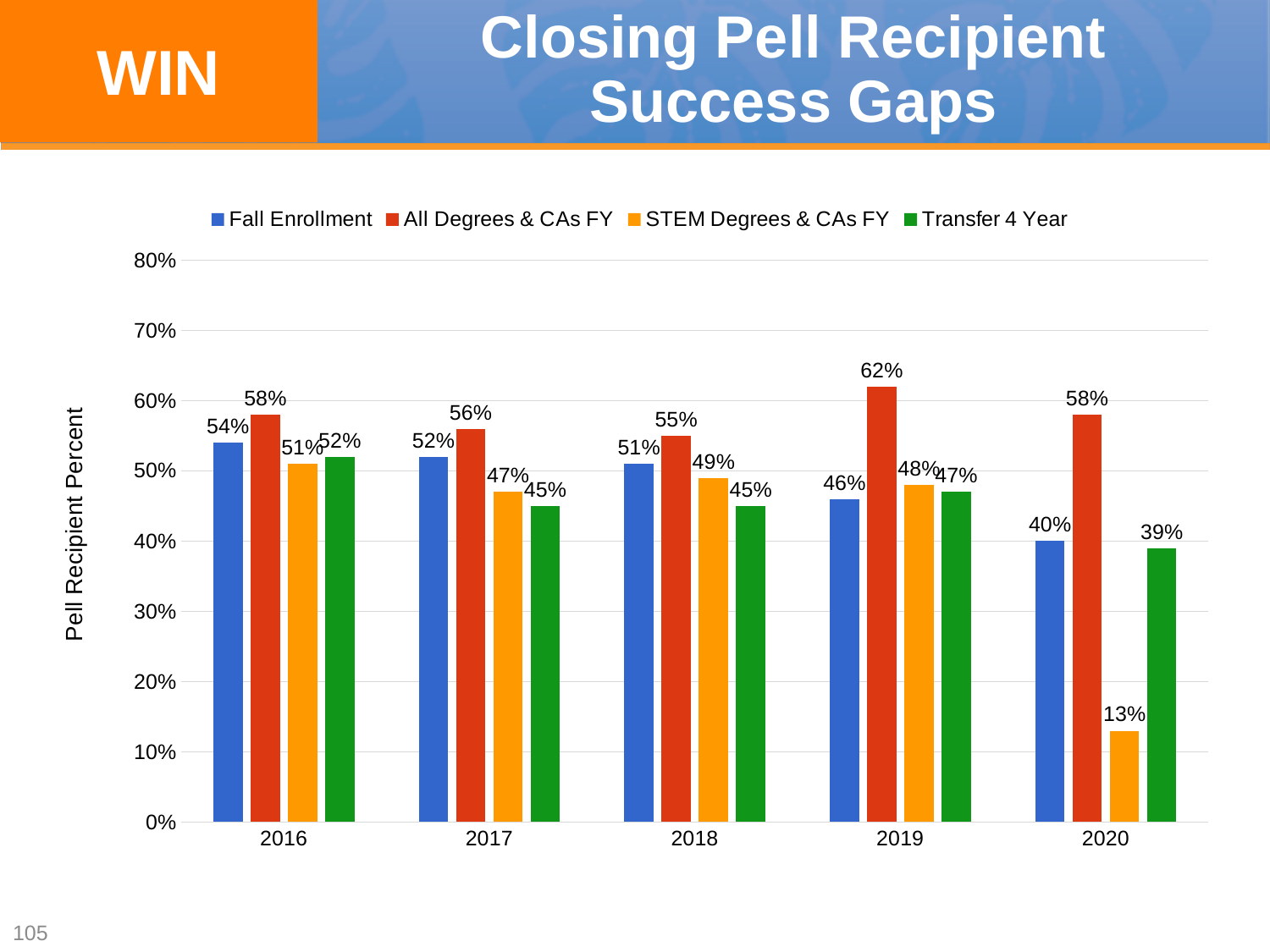
What is the STEM Degrees & CAs FY value for 2020? 13% What is the difference between the All Degrees & CAs FY value and the STEM Degrees & CAs FY value in 2020? 45% What is the Fall Enrollment value for 2016? 54% In which year is the All Degrees & CAs FY value highest? 2019 Which is larger in 2017: the Fall Enrollment value or the Transfer 4 Year value? Fall Enrollment Does the Fall Enrollment value rise or fall from 2016 to 2020? Fall In which year is the Fall Enrollment value lowest? 2020 What is the All Degrees & CAs FY value for 2019? 62% How many years are shown on the x axis? 5 How many series does the legend list? 4 What kind of chart is shown on the slide? Bar chart What is the Transfer 4 Year value for 2018? 45%